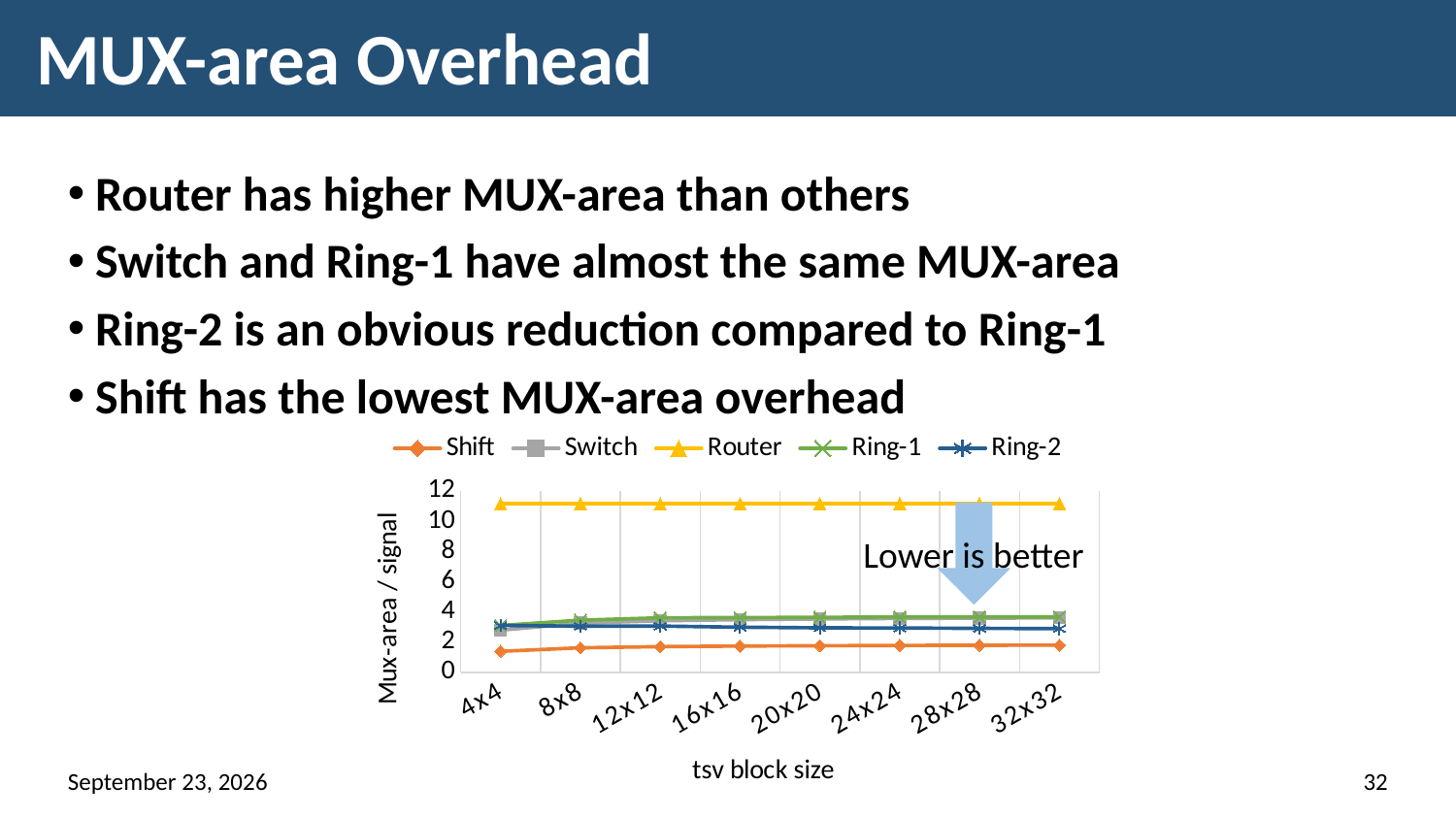
Is the value for Shift at 4x4 greater or less than 2? less How many series does the chart legend list? 5 Which series has the lowest Mux-area / signal across all tsv block sizes? Shift What kind of chart is shown on the slide? line chart Which series has the highest Mux-area / signal across all tsv block sizes? Router What is the label of the y axis? Mux-area / signal Is the value for Router at 16x16 greater or less than 10? greater What is the label of the x axis? tsv block size How many tsv block sizes are plotted along the x axis? 8 Which is larger at 20x20, the value for Router or the value for Ring-1? Router Is the value for Ring-2 at 32x32 greater or less than 4? less Which is larger at 8x8, the value for Ring-2 or the value for Shift? Ring-2